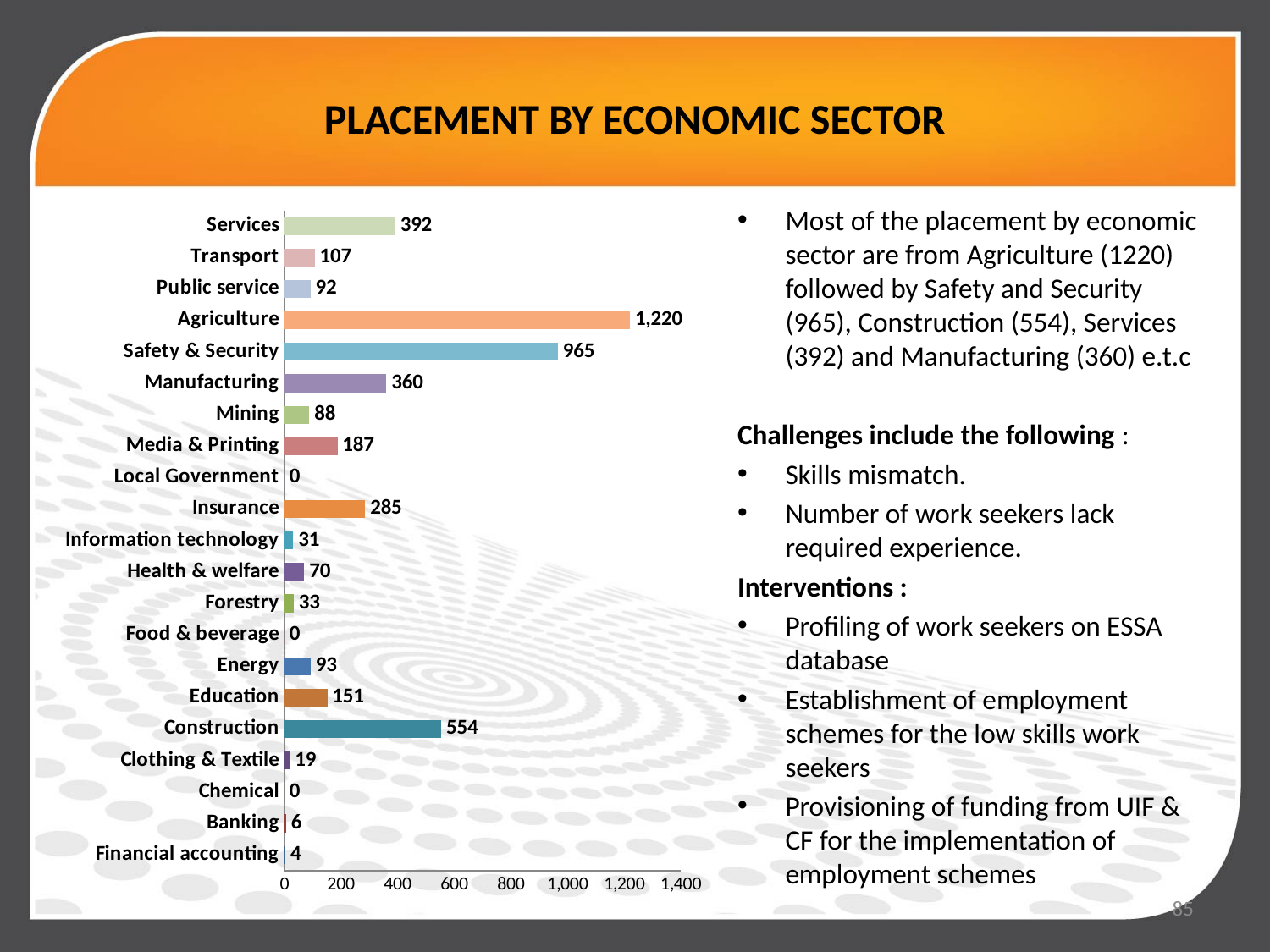
What kind of chart is shown on the slide? Bar chart How many sectors are shown on the chart? 21 Is the value for Safety & Security greater or less than 800? greater Which is larger, the value for Insurance or the value for Education? Insurance What is the difference between the values for Agriculture and Safety & Security? 255 What is the difference between the values for Services and Manufacturing? 32 Which is larger, the value for Transport or the value for Energy? Transport What is the value for Agriculture? 1,220 Which sector has the highest value? Agriculture What is the value for Financial accounting? 4 What is the value for Construction? 554 What is the value for Media & Printing? 187